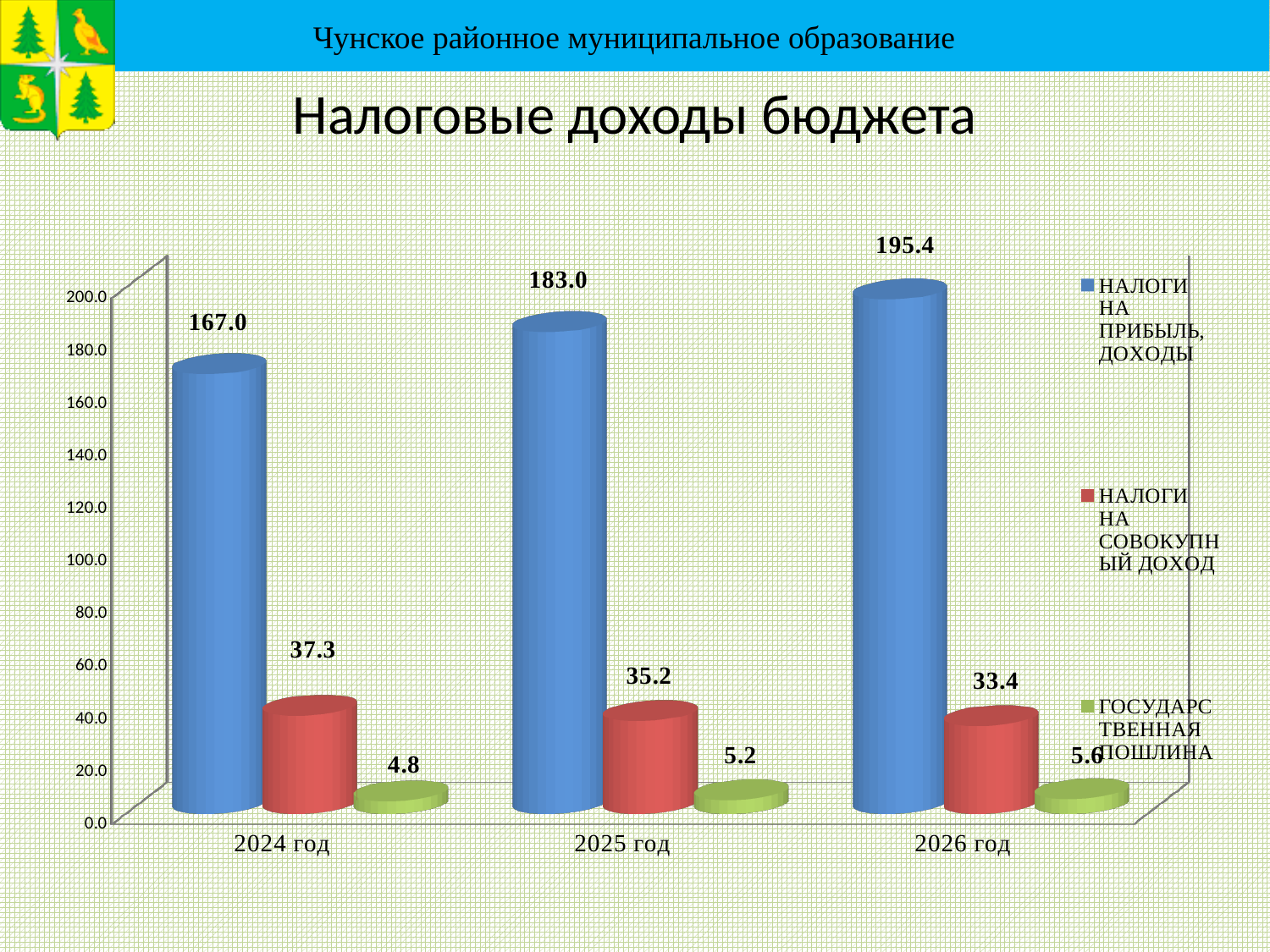
How many years are shown on the x axis? 3 What is the value of НАЛОГИ НА ПРИБЫЛЬ, ДОХОДЫ for 2024 год? 167.0 In which year is ГОСУДАРСТВЕННАЯ ПОШЛИНА lowest? 2024 год In which year is НАЛОГИ НА ПРИБЫЛЬ, ДОХОДЫ highest? 2026 год What kind of chart is shown on the slide? bar chart Is the value of НАЛОГИ НА ПРИБЫЛЬ, ДОХОДЫ for 2025 год greater or less than 180.0? greater Does НАЛОГИ НА СОВОКУПНЫЙ ДОХОД rise or fall from 2024 год to 2026 год? fall What is the value of НАЛОГИ НА СОВОКУПНЫЙ ДОХОД for 2025 год? 35.2 What is the difference between НАЛОГИ НА ПРИБЫЛЬ, ДОХОДЫ in 2026 год and in 2024 год? 28.4 What is the value of ГОСУДАРСТВЕННАЯ ПОШЛИНА for 2026 год? 5.6 Which is larger: НАЛОГИ НА СОВОКУПНЫЙ ДОХОД in 2024 год or in 2026 год? 2024 год How many series does the legend list? 3